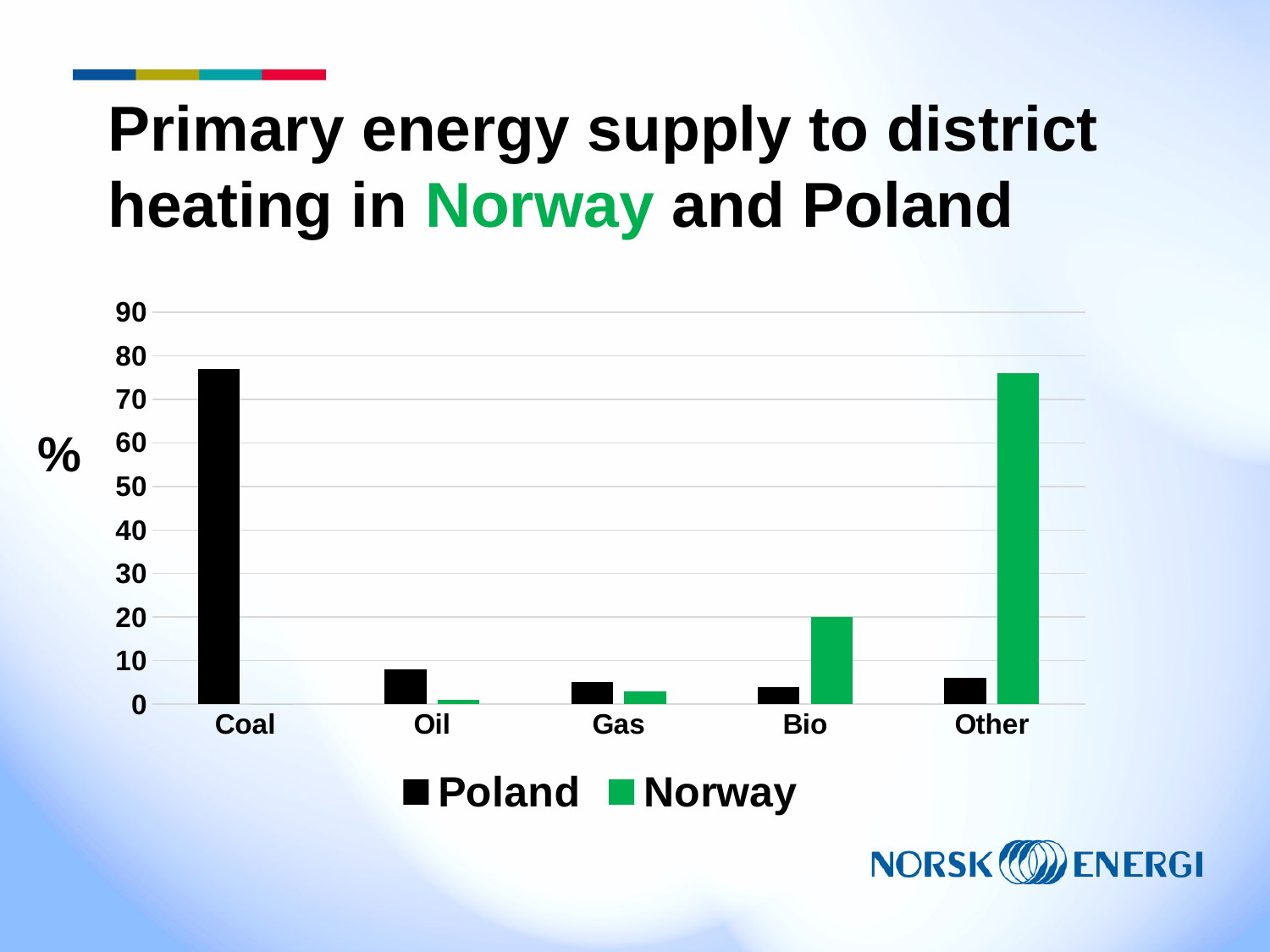
Is the value for Other in Norway greater or less than 70? greater Which colour represents Norway in the legend? green For Coal, which country has the larger value, Poland or Norway? Poland Which category has the highest value for Norway? Other For Bio, which country has the larger value, Poland or Norway? Norway Is the value for Coal in Poland greater or less than 70? greater How many energy source categories are shown on the x axis? 5 How many series does the legend list? 2 What kind of chart is shown on the slide? bar chart Is the value for Bio in Norway greater or less than 30? less Which category has the highest value for Poland? Coal